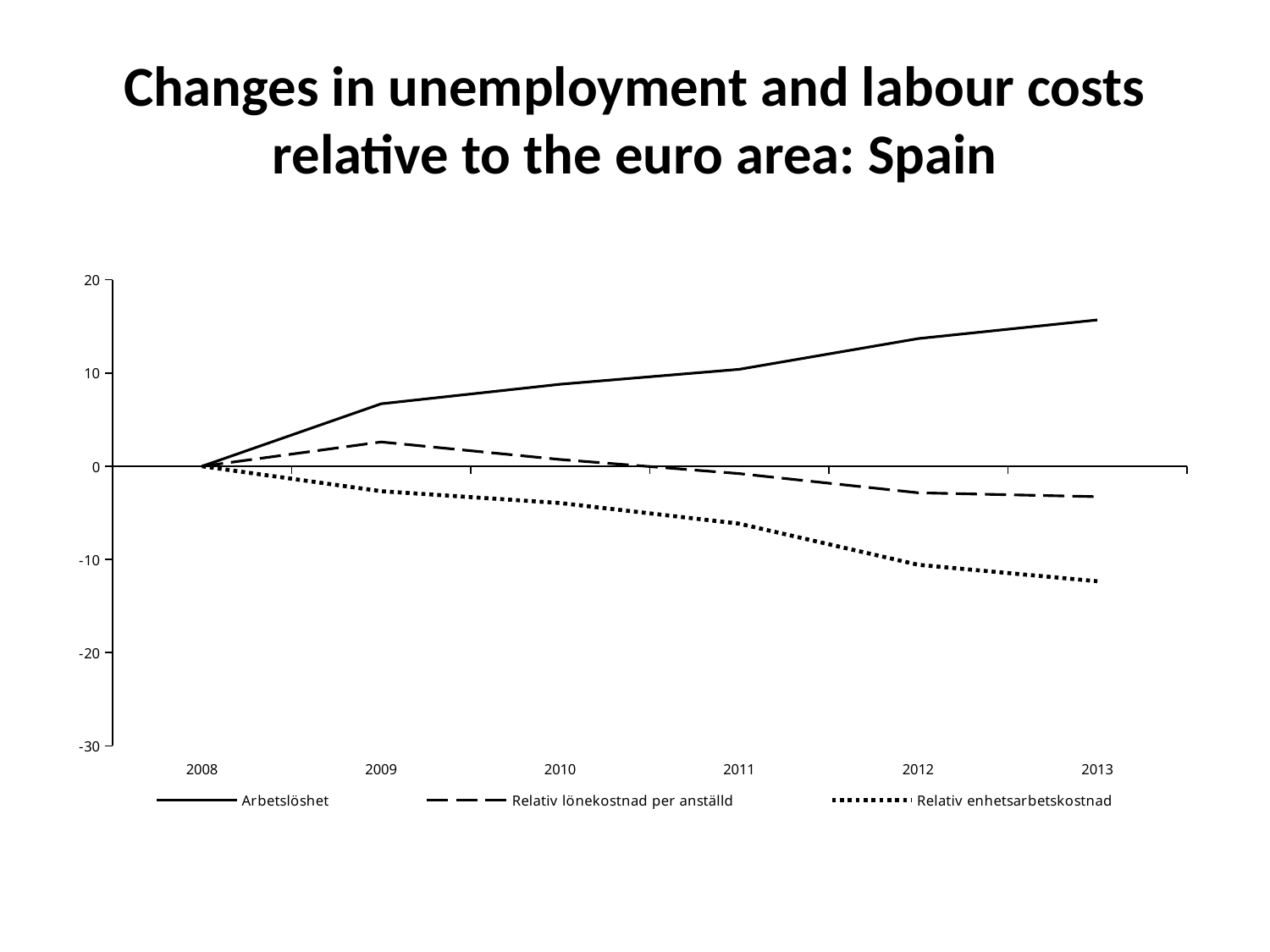
Is the value for Arbetslöshet in 2013 greater or less than 10? greater Which series has the highest value in 2013? Arbetslöshet Which series has the lowest value in 2013? Relativ enhetsarbetskostnad Is the value for Relativ enhetsarbetskostnad in 2013 greater or less than -10? less Does the Relativ enhetsarbetskostnad line rise or fall from 2008 to 2013? fall What is the value of Arbetslöshet in 2008? 0 What kind of chart is shown on the slide? line chart How many series does the legend list? 3 How many years are shown on the x axis? 6 Is the value for Arbetslöshet in 2009 greater or less than 10? less Which series is drawn with a dotted line? Relativ enhetsarbetskostnad